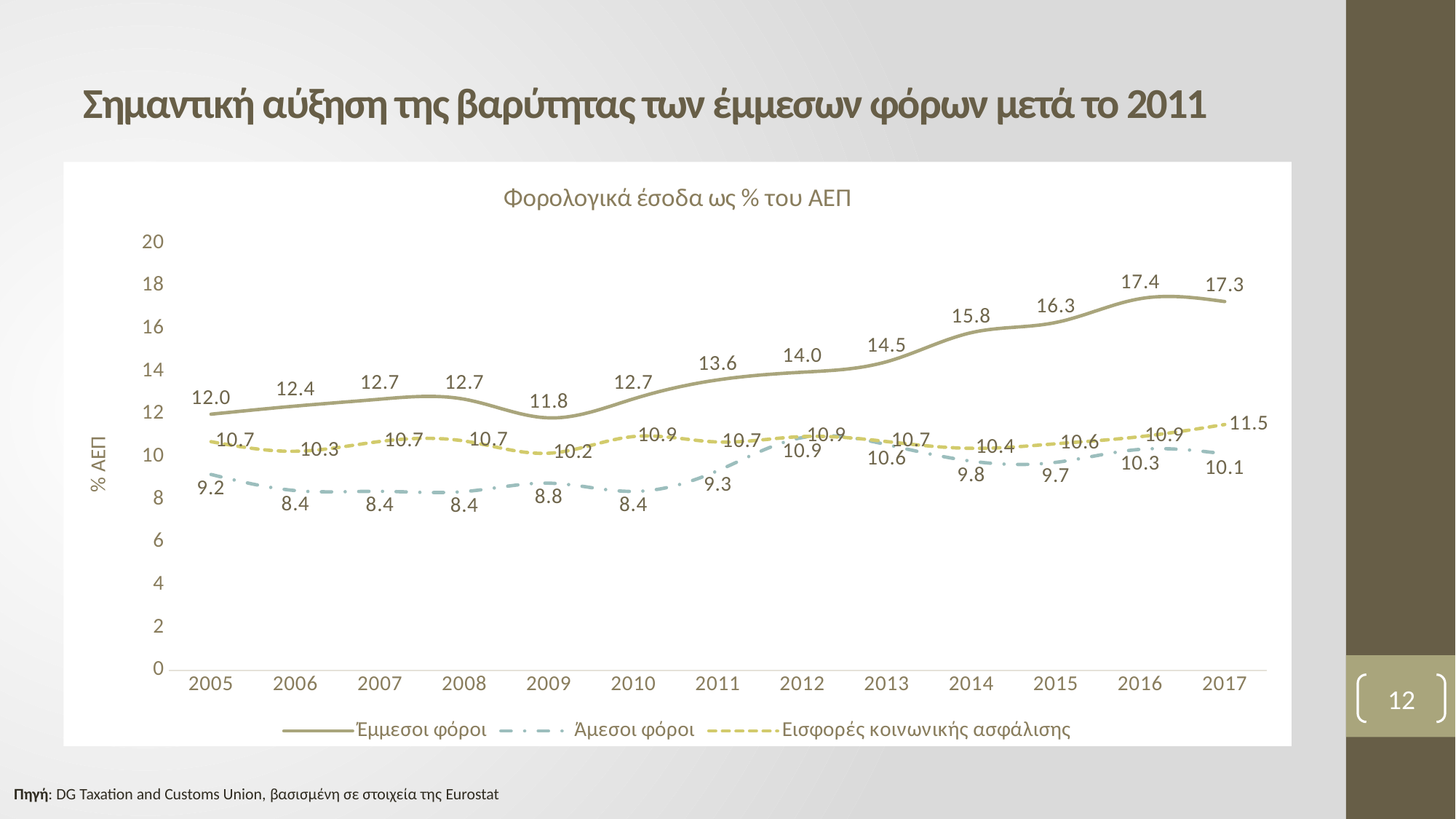
In which year is Έμμεσοι φόροι highest? 2016 What is the difference between Έμμεσοι φόροι in 2017 and in 2005? 5.3 What is the value for Εισφορές κοινωνικής ασφάλισης in 2017? 11.5 What type of chart is shown on the slide? line chart How many years are shown on the x axis? 13 In which year is Έμμεσοι φόροι lowest? 2009 What is the title of the chart? Φορολογικά έσοδα ως % του ΑΕΠ What is the value for Άμεσοι φόροι in 2009? 8.8 How many series does the legend list? 3 Does Έμμεσοι φόροι generally rise or fall from 2011 to 2016? rise What is the value for Έμμεσοι φόροι in 2017? 17.3 Which is larger in 2013: Άμεσοι φόροι or Εισφορές κοινωνικής ασφάλισης? Εισφορές κοινωνικής ασφάλισης